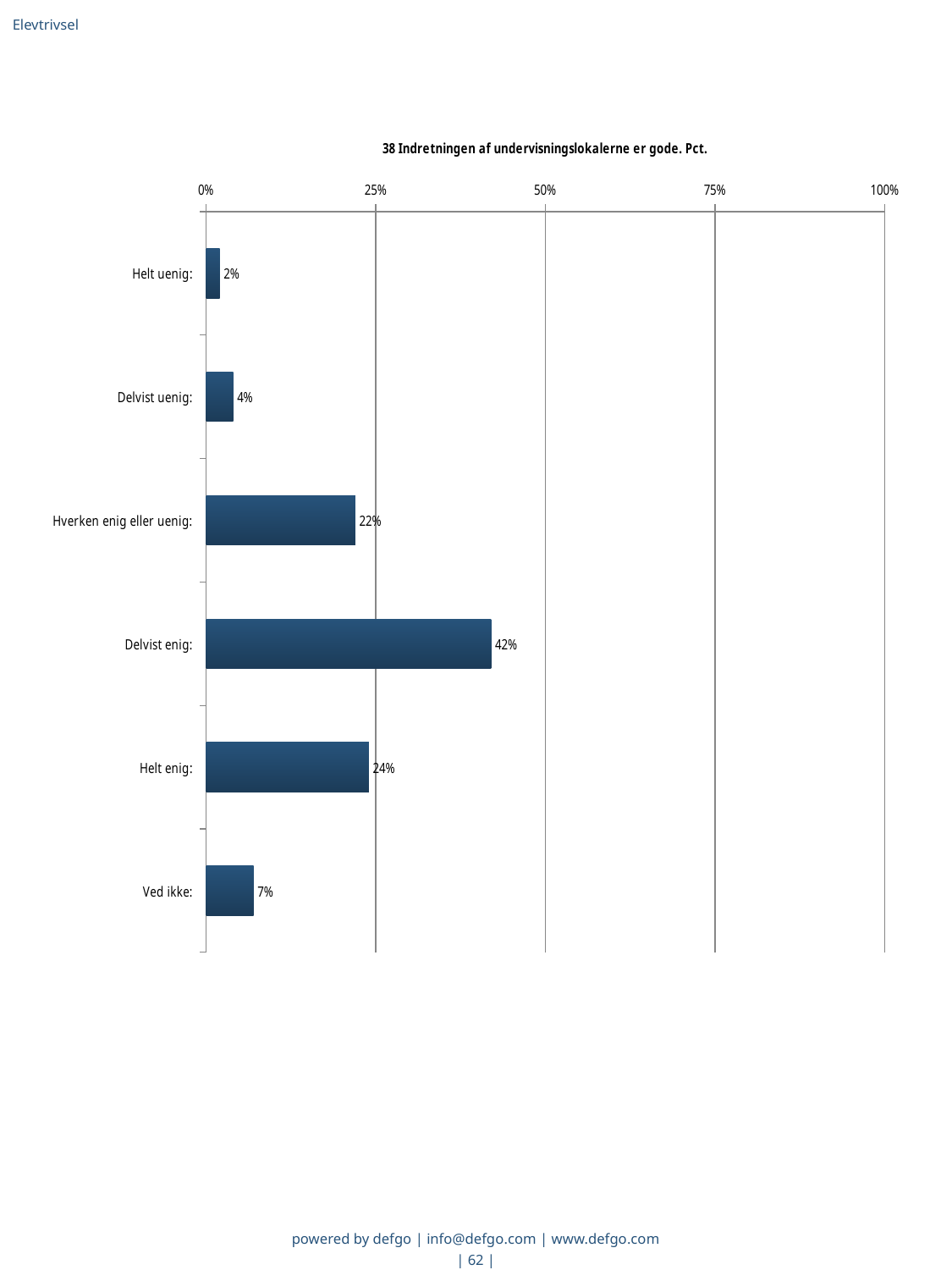
What is the value for "Ved ikke"? 7% What is the value for "Hverken enig eller uenig"? 22% What is the title of the chart? 38 Indretningen af undervisningslokalerne er gode. Pct. How many categories are shown in the chart? 6 What is the highest value shown on the percentage axis? 100% What kind of chart is shown on the slide? bar chart What is the value for "Delvist enig"? 42% Which category has the lowest value? Helt uenig Is the value for "Delvist enig" greater or less than 25%? greater Which is larger, the value for "Helt enig" or the value for "Hverken enig eller uenig"? Helt enig Which category has the highest value? Delvist enig What is the difference between the values for "Delvist enig" and "Helt enig"? 18%